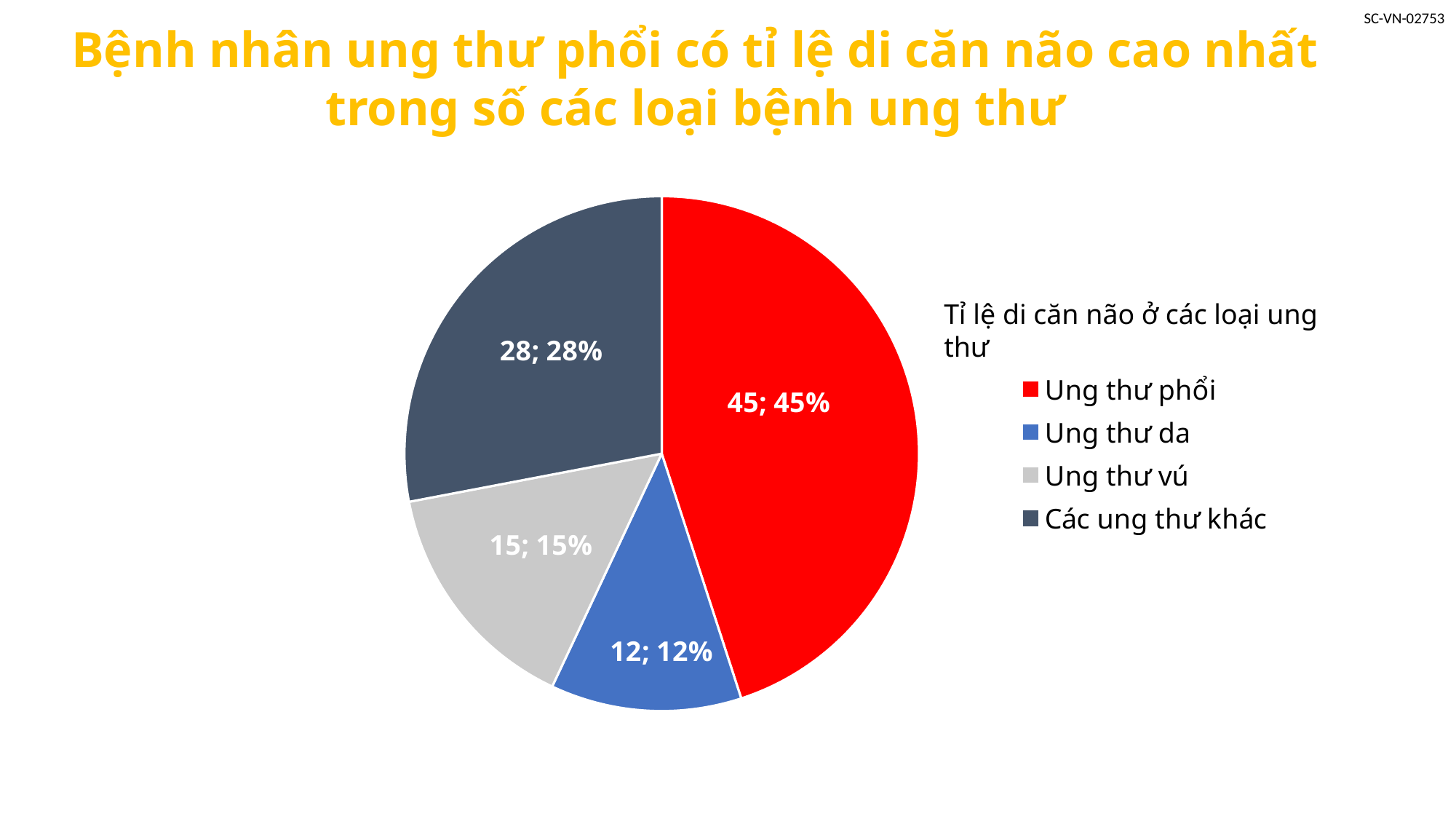
Which category has the largest slice? Ung thư phổi How many slices does the pie chart have? 4 What is the chart's title? Tỉ lệ di căn não ở các loại ung thư What is the difference between the values for Ung thư phổi and Các ung thư khác? 17 Which category has the smallest slice? Ung thư da What kind of chart is shown on the slide? pie chart Which colour represents Ung thư phổi in the legend? red What percentage of the pie does Ung thư phổi account for? 45% What percentage of the pie does Ung thư vú account for? 15% What value is shown for Ung thư da? 12 What value is shown for Các ung thư khác? 28 Which is larger, the value for Ung thư vú or the value for Ung thư da? Ung thư vú